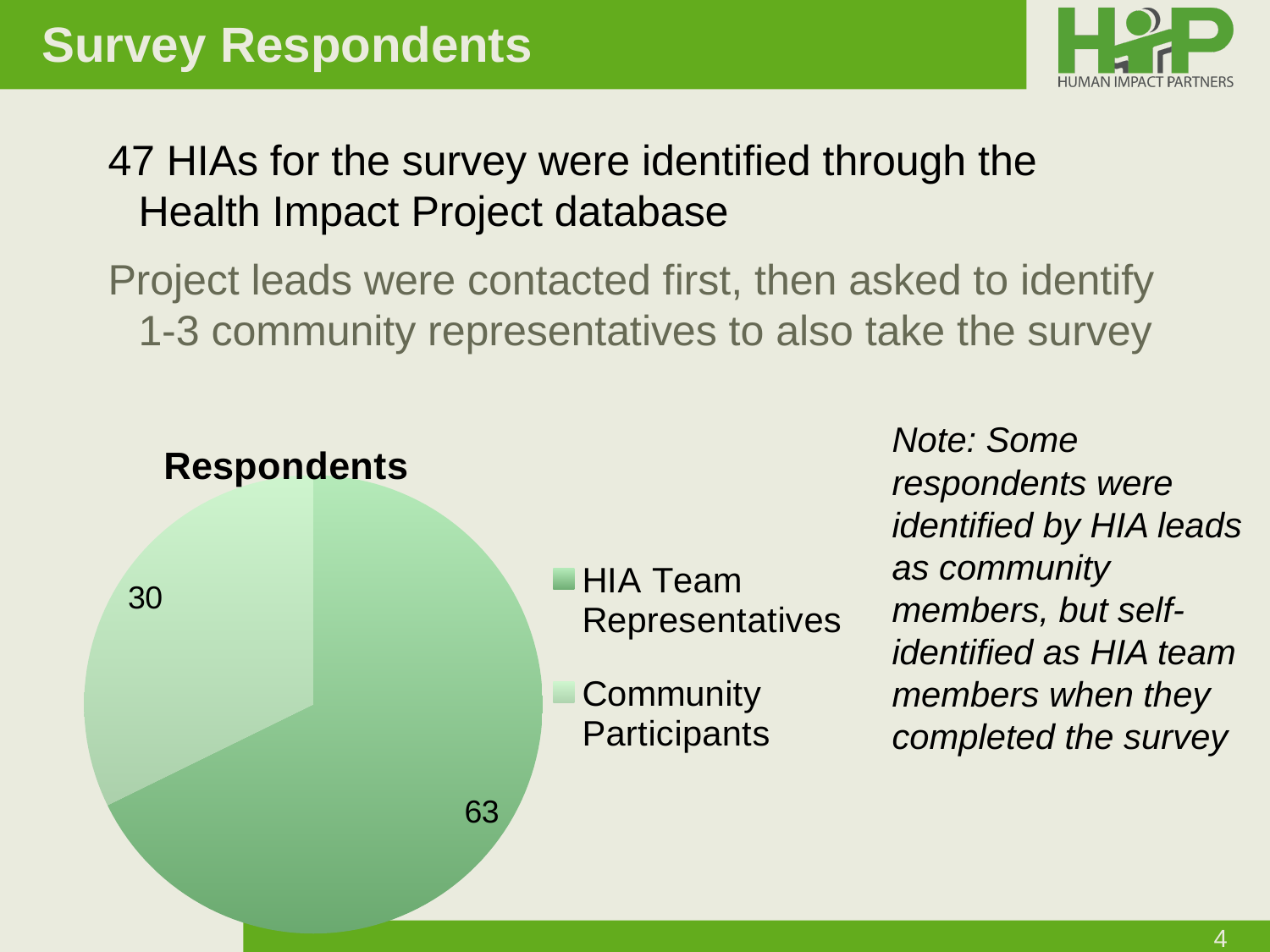
How many entries does the legend list? 2 Which is larger: the number of HIA Team Representatives or the number of Community Participants? HIA Team Representatives What is the title of the chart? Respondents Which category has the largest slice of the pie? HIA Team Representatives What type of chart is shown on the slide? pie chart How many respondents were HIA Team Representatives? 63 What is the total number of respondents shown in the pie chart? 93 How many categories does the pie chart show? 2 How many respondents were Community Participants? 30 Which category has the smallest slice of the pie? Community Participants What is the difference between the number of HIA Team Representatives and Community Participants? 33